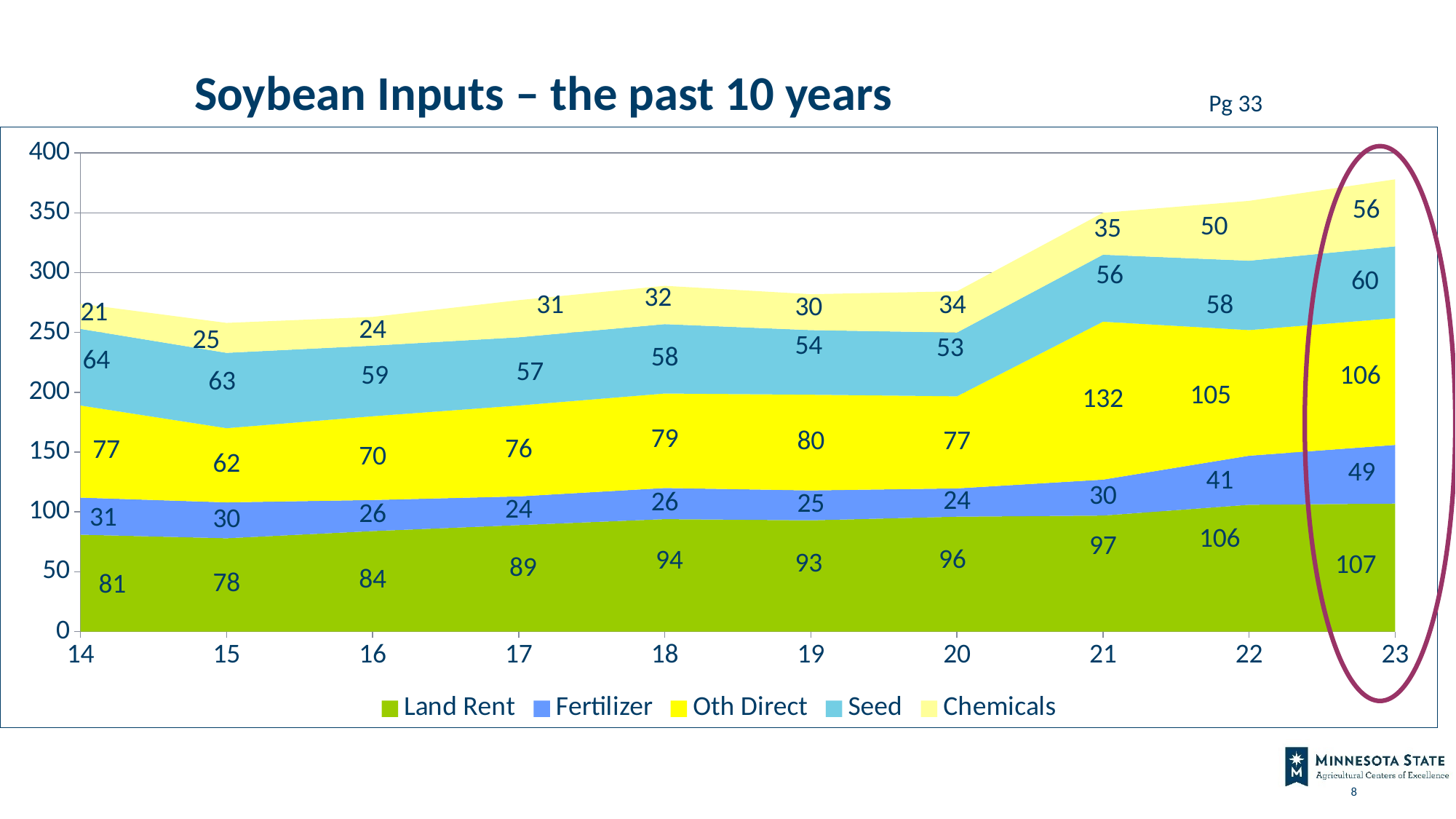
In which year is the Oth Direct value highest? 21 What kind of chart is shown on the slide? Stacked area chart In which year is the Land Rent value lowest? 15 What is the total of all five inputs for year 23? 378 How many series does the legend list? 5 What is the Land Rent value for year 23? 107 Does the Chemicals value rise or fall from year 14 to year 23? Rise Which is larger, the Seed value for year 14 or the Seed value for year 20? Year 14 What is the Oth Direct value for year 21? 132 How many years are shown along the x axis? 10 What is the difference between the Fertilizer values for year 23 and year 22? 8 What is the Chemicals value for year 14? 21